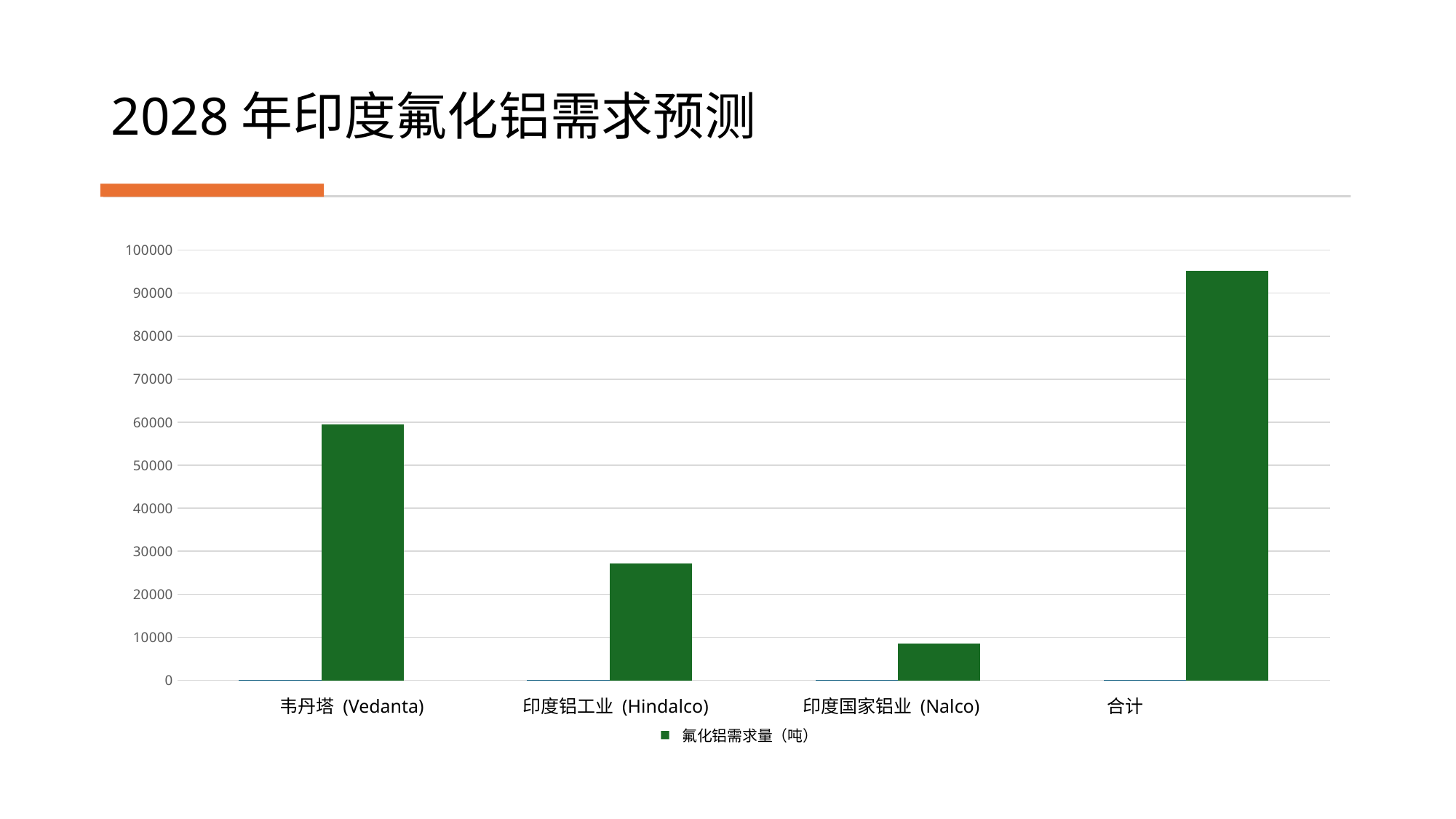
How many series does the chart legend list? 1 What kind of chart is shown on the slide? bar chart Which category has the highest bar in the chart? 合计 Which category has the lowest bar in the chart? 印度国家铝业 (Nalco) Is the value for 合计 greater or less than 90000? greater Is the value for 印度铝工业 (Hindalco) greater or less than 30000? less What series name is shown in the chart legend? 氟化铝需求量（吨） Which is larger, the value for 韦丹塔 (Vedanta) or the value for 印度铝工业 (Hindalco)? 韦丹塔 (Vedanta) What is the title of the slide? 2028 年印度氟化铝需求预测 Is the value for 韦丹塔 (Vedanta) greater or less than 50000? greater How many categories are shown on the x axis of the chart? 4